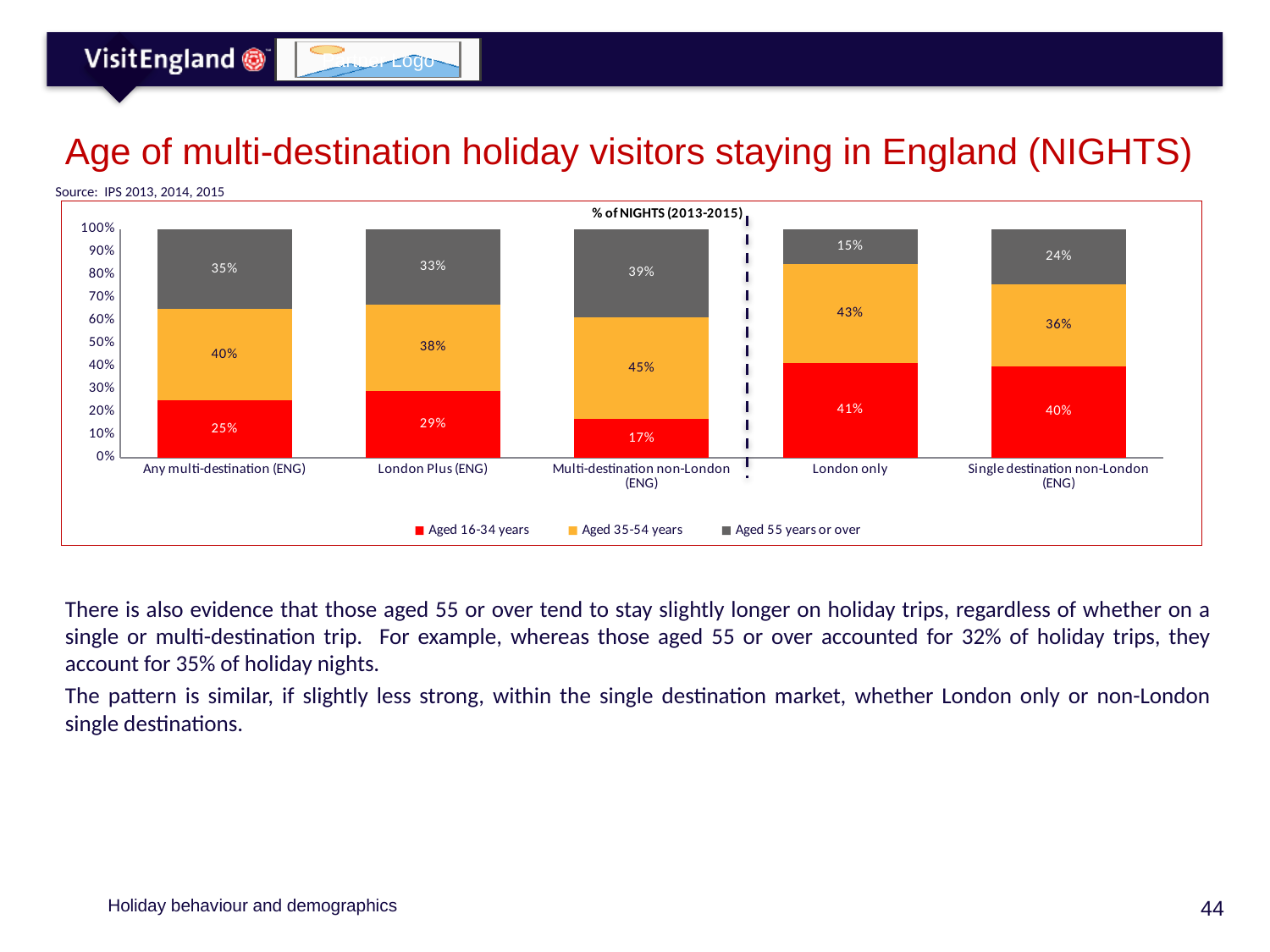
How many categories are shown on the x axis? 5 What share of nights for London Plus (ENG) is from visitors aged 35-54 years? 38% What is the value for Aged 55 years or over in the Multi-destination non-London (ENG) bar? 39% What percentage of nights for London only visitors is accounted for by those aged 16-34 years? 41% Which category has the highest value for Aged 16-34 years? London only How many series does the legend list? 3 Which is larger: the Aged 16-34 years value for Any multi-destination (ENG) or for London Plus (ENG)? London Plus (ENG) What is the title shown above the chart? % of NIGHTS (2013-2015) Which colour represents Aged 55 years or over in the chart? Grey What kind of chart is shown on the slide? Stacked bar chart Which category has the lowest value for Aged 55 years or over? London only What is the difference between the Aged 35-54 years values for Multi-destination non-London (ENG) and Single destination non-London (ENG)? 9%